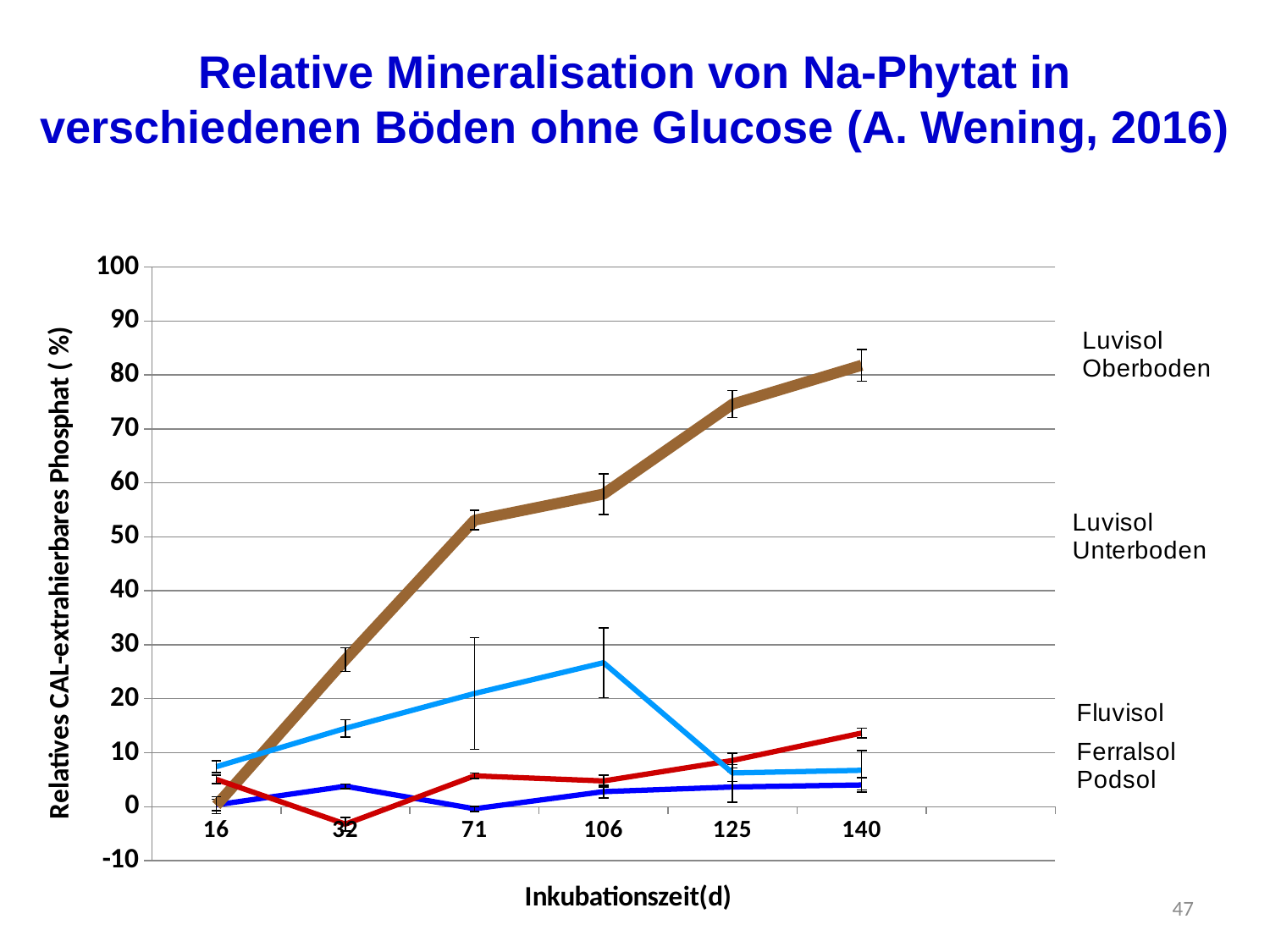
What is the title of the x axis? Inkubationszeit(d) Is the value of the light blue line at 106 days greater or less than 20? greater At which incubation time does the thick brown line reach its highest value? 140 Is the value of the thick brown line at 140 days greater or less than 70? greater Does the thick brown line rise or fall as incubation time increases from 16 to 140 days? rises Is the value of the red line at 32 days greater or less than 0? less At which incubation time does the thick brown line have its lowest value? 16 What is the title of the y axis? Relatives CAL-extrahierbares Phosphat ( %) How many incubation time points are shown on the x axis? 6 What kind of chart is shown on the slide? line chart